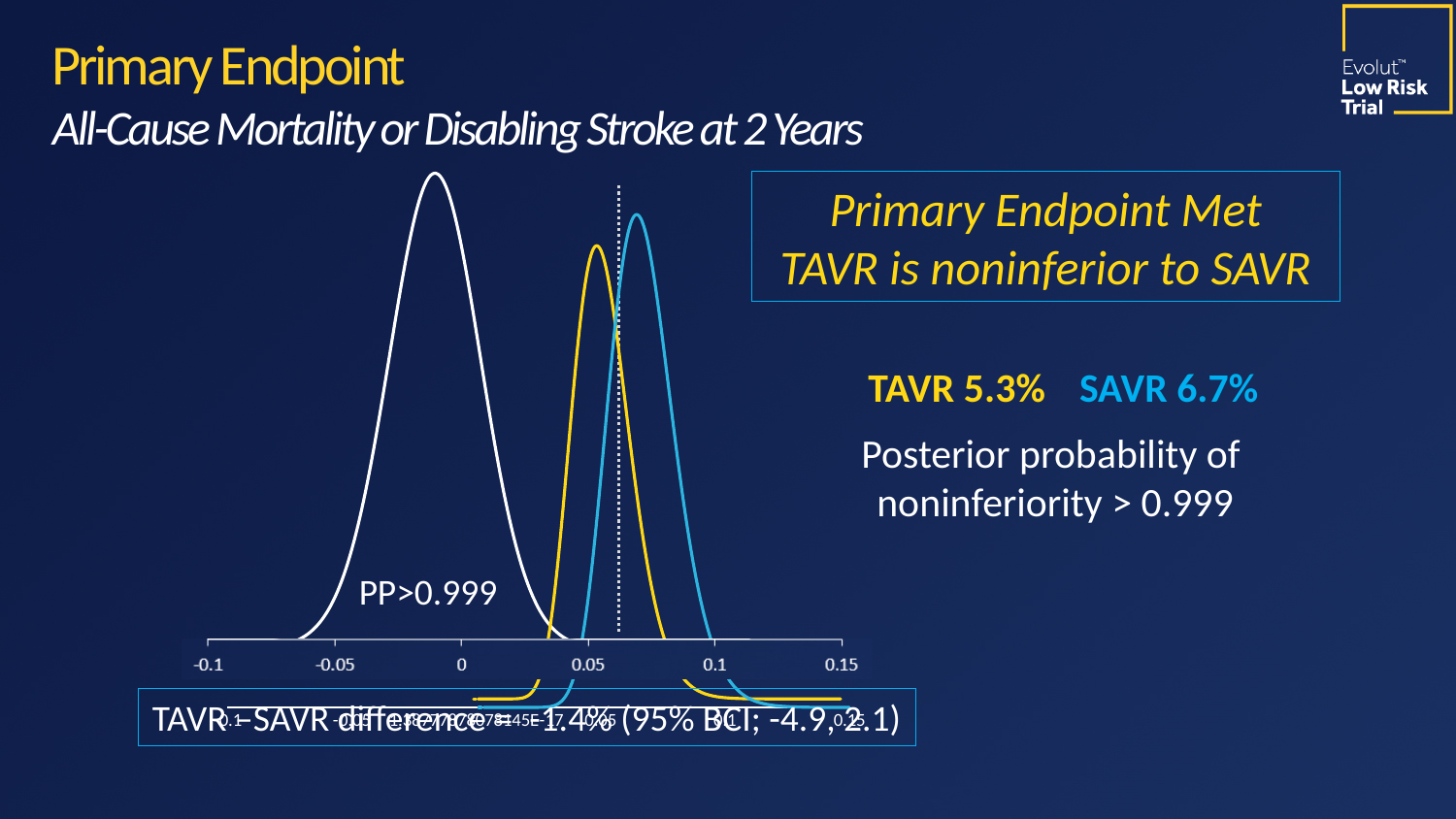
What is the lowest tick label on the x axis of the chart? -0.1 Is the peak of the white curve located at an x value greater or less than 0.05? less What is the highest tick label on the x axis of the chart? 0.15 How many curves are plotted on the chart? 3 How many tick labels are shown on the x axis of the chart? 6 What kind of chart is shown on the slide? line chart Which curve reaches the highest peak on the chart? the white curve Which curve peaks further to the right on the x axis, the yellow curve or the blue curve? the blue curve What is the 2-year rate of all-cause mortality or disabling stroke for SAVR shown on the slide? 6.7% What is the 2-year rate of all-cause mortality or disabling stroke for TAVR shown on the slide? 5.3% Is the peak of the blue curve located at an x value greater or less than 0.05? greater What TAVR–SAVR difference is reported on the slide? -1.4% (95% BCI; -4.9, 2.1)